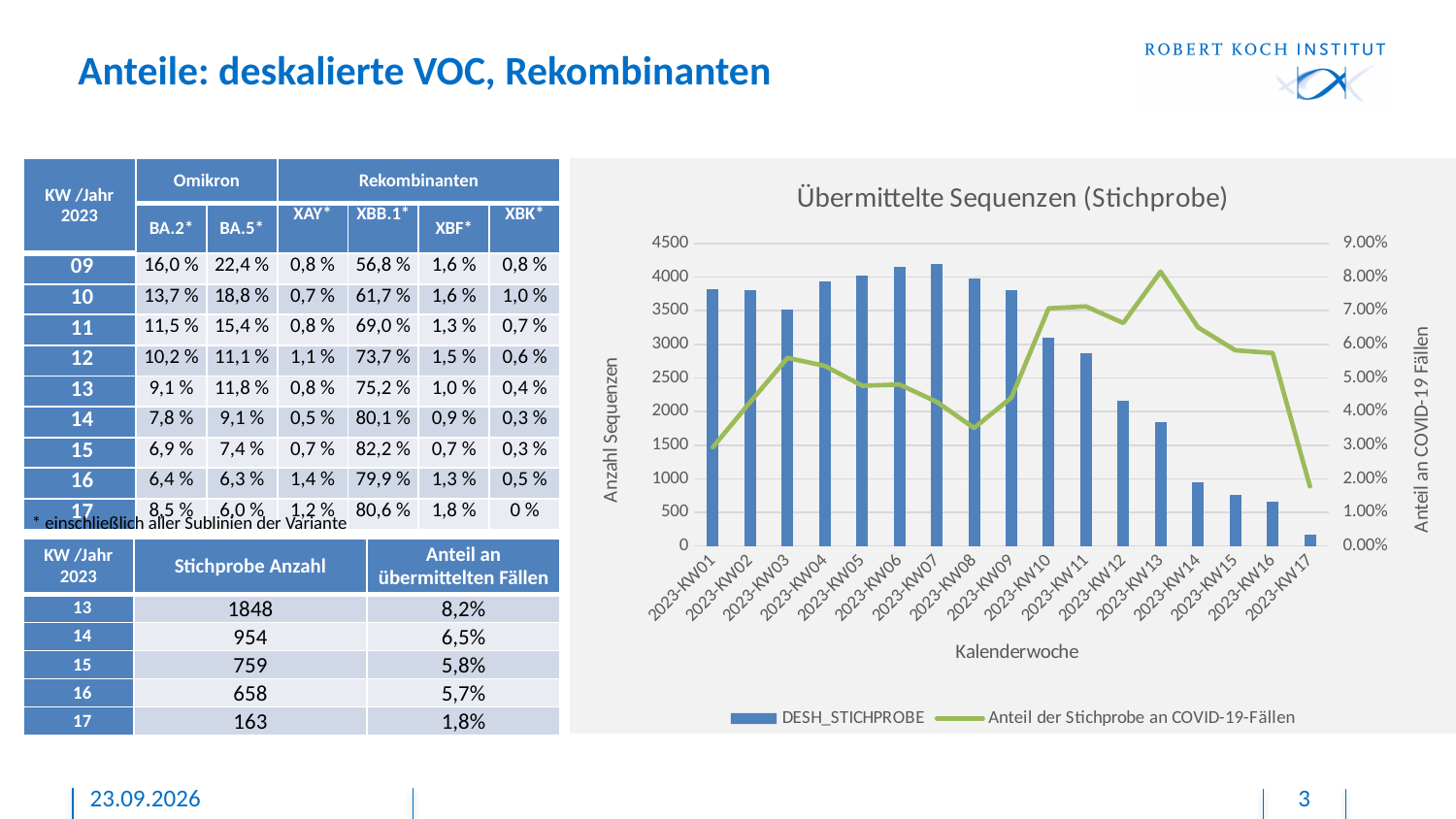
Which calendar week has the lowest DESH_STICHPROBE bar? 2023-KW17 How many calendar weeks are shown on the x axis of the chart? 17 What kind of chart is 'Übermittelte Sequenzen (Stichprobe)'? A combined bar and line chart Is the 'Anteil der Stichprobe an COVID-19-Fällen' value for 2023-KW10 greater or less than 6.00%? greater Is the DESH_STICHPROBE bar for 2023-KW01 greater or less than 3500? greater How many series does the chart legend list? 2 What is the title of the left vertical axis of the chart? Anzahl Sequenzen Do the DESH_STICHPROBE bars rise or fall from 2023-KW07 to 2023-KW17? fall Which has the larger DESH_STICHPROBE bar, 2023-KW02 or 2023-KW03? 2023-KW02 In which calendar week does the line 'Anteil der Stichprobe an COVID-19-Fällen' reach its highest point? 2023-KW13 Is the 'Anteil der Stichprobe an COVID-19-Fällen' value for 2023-KW08 greater or less than 4.00%? less